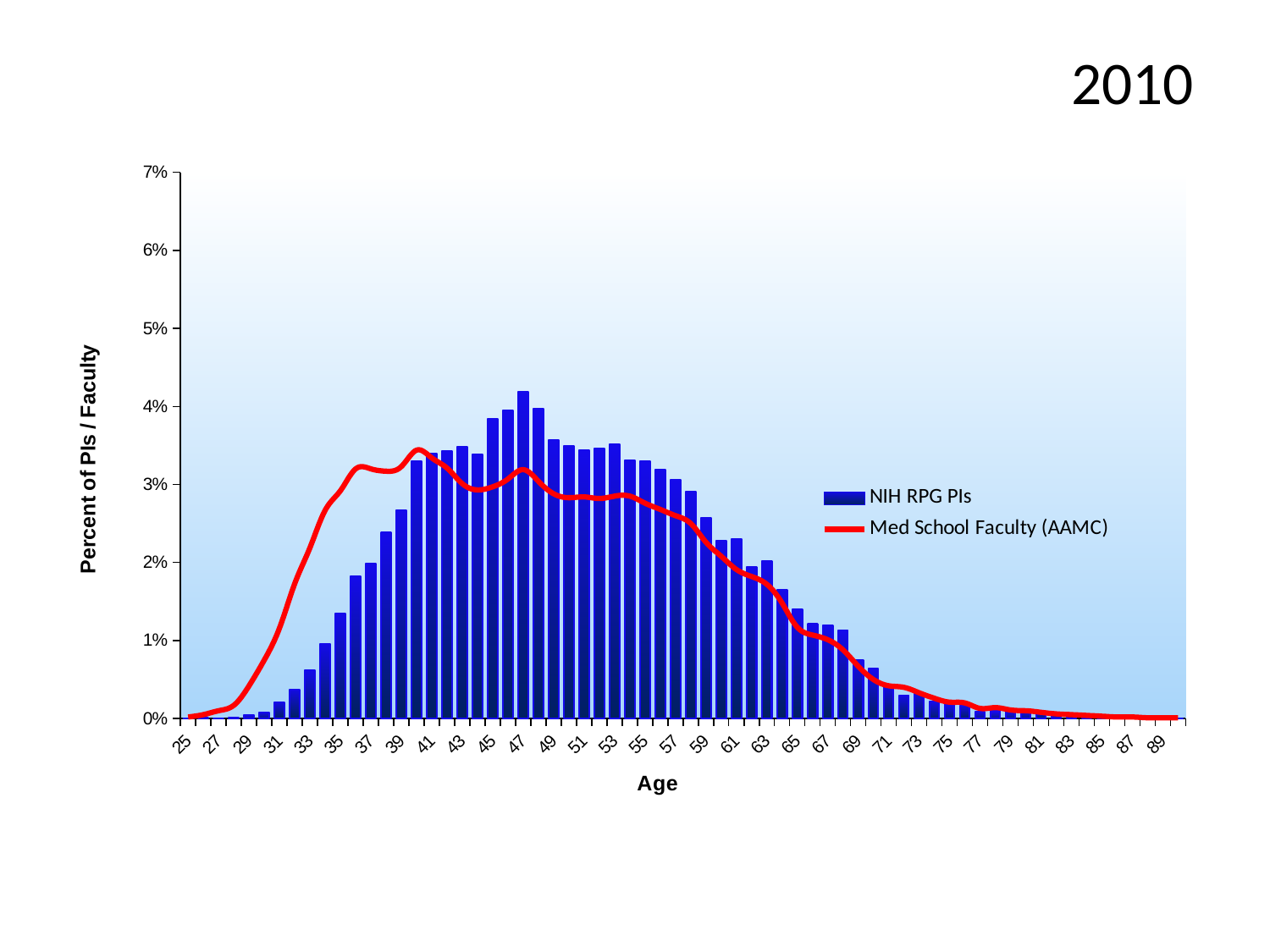
Is the NIH RPG PIs value at age 35 greater or less than 1%? greater Do the NIH RPG PIs values rise or fall as age increases from 47 to 89? fall At which age is the NIH RPG PIs bar the highest? 47 Is the Med School Faculty (AAMC) value at age 37 greater or less than 3%? greater Is the NIH RPG PIs value at age 75 greater or less than 1%? less How many series does the legend list? 2 At age 37, which is larger: the NIH RPG PIs bar or the Med School Faculty (AAMC) line? Med School Faculty (AAMC) What are the two series named in the legend? NIH RPG PIs; Med School Faculty (AAMC) What is the title of the vertical axis? Percent of PIs / Faculty Which is larger: the NIH RPG PIs value at age 47 or at age 35? age 47